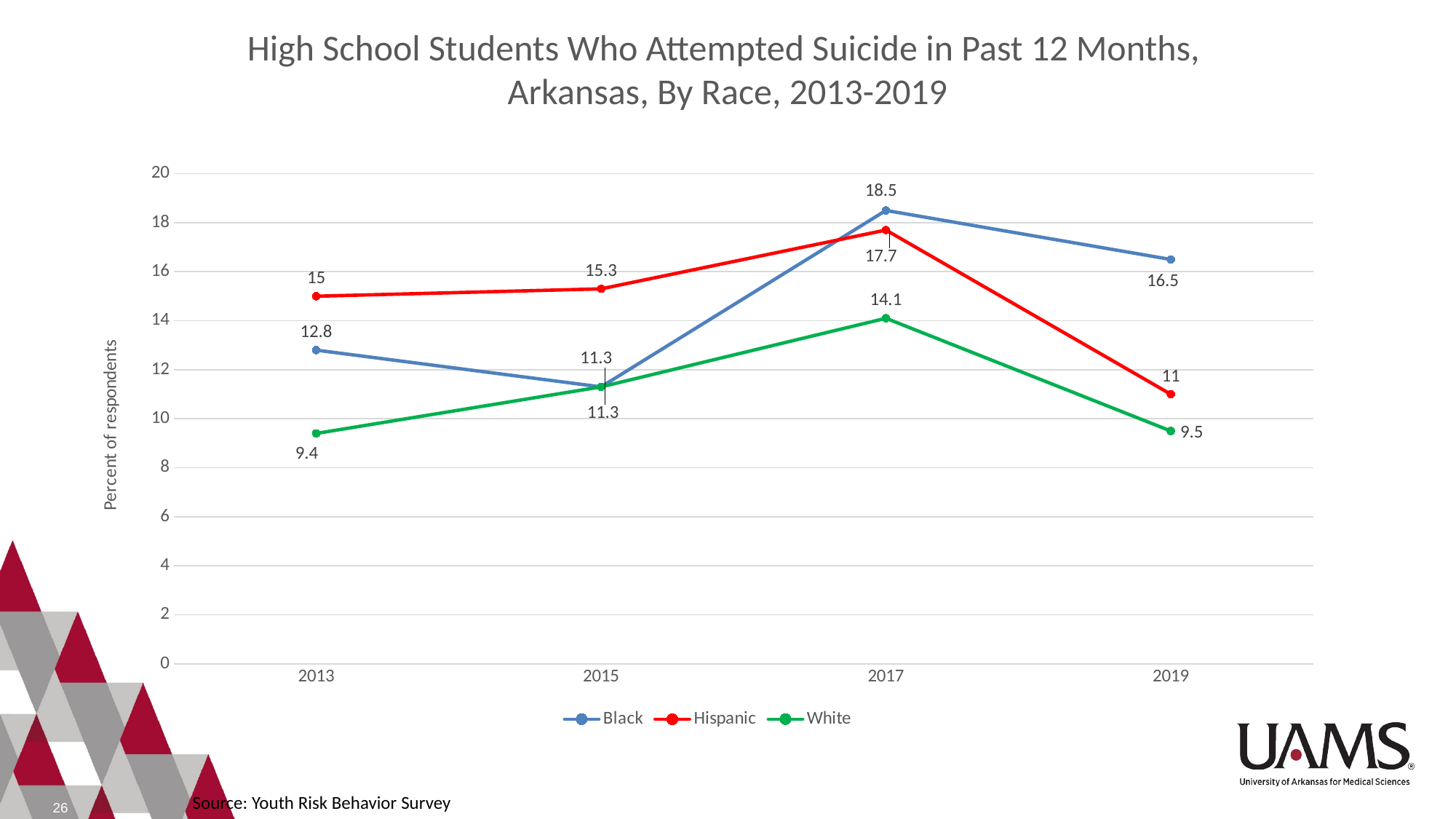
How many series does the legend list? 3 In which year was the value for White students lowest? 2013 What is the label on the vertical axis? Percent of respondents What was the value for White students in 2013? 9.4 How many years are plotted along the x axis? 4 What type of chart is shown on the slide? line chart Did the value for Hispanic students rise or fall from 2017 to 2019? fall Which group had the larger value in 2013, Black or Hispanic? Hispanic What was the value for Hispanic students in 2019? 11 What is the difference between the Black and White values in 2019? 7 What was the value for Black students in 2017? 18.5 In which year was the value for Hispanic students highest? 2017